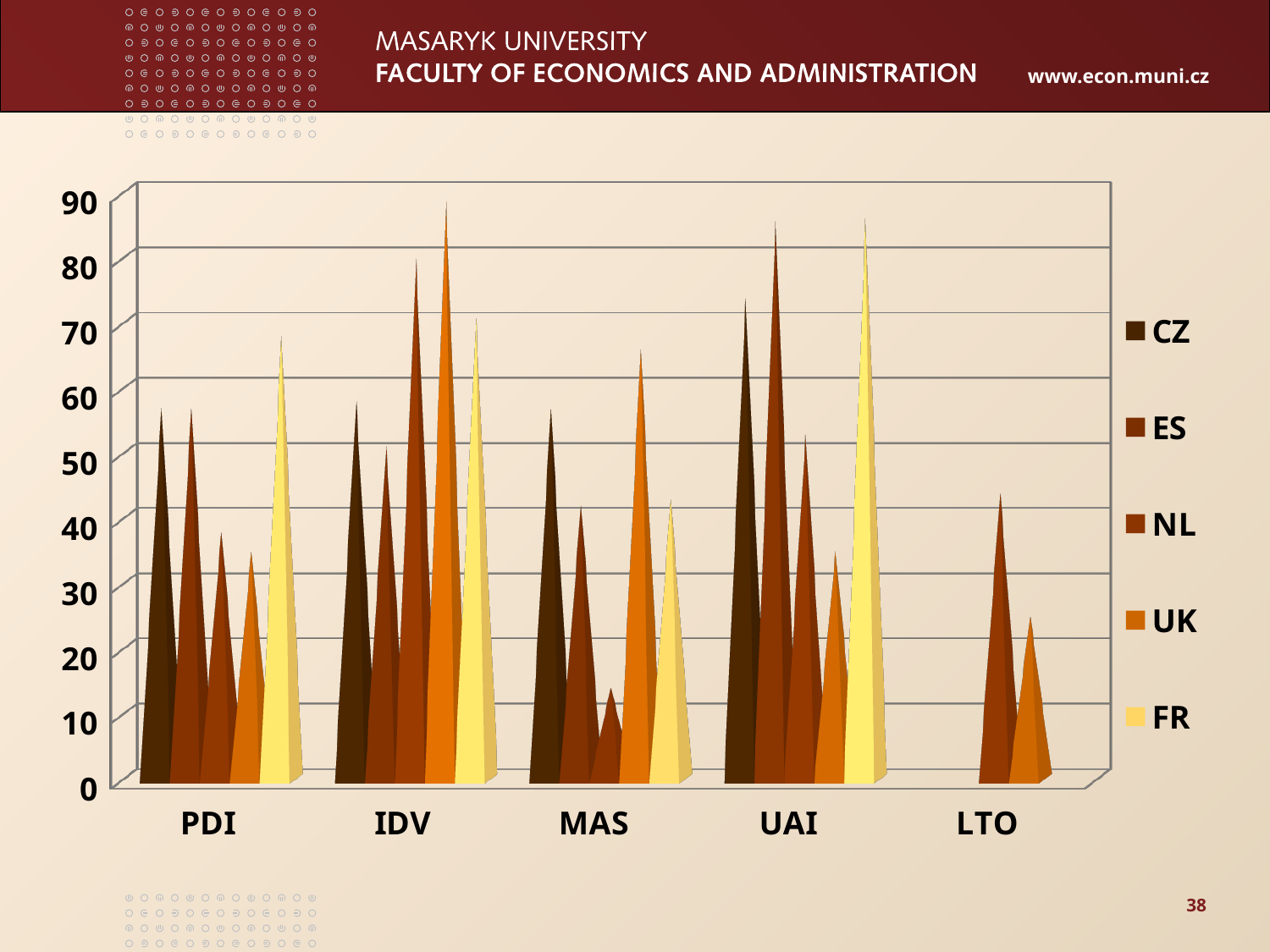
Which series has the highest value in the IDV category? UK Which series has the lowest value in the MAS category? NL How many bars are plotted in the LTO category? 2 How many series does the chart's legend list? 5 In the PDI category, which is larger: the value for FR or the value for NL? FR What kind of chart is shown on the slide? bar chart Which series has the lowest value in the UAI category? UK Is the value for NL in the MAS category greater or less than 20? less How many categories are shown on the x axis of the chart? 5 Is the value for FR in the PDI category greater or less than 60? greater Is the value for UK in the LTO category greater or less than 30? less Which series has the highest value in the PDI category? FR